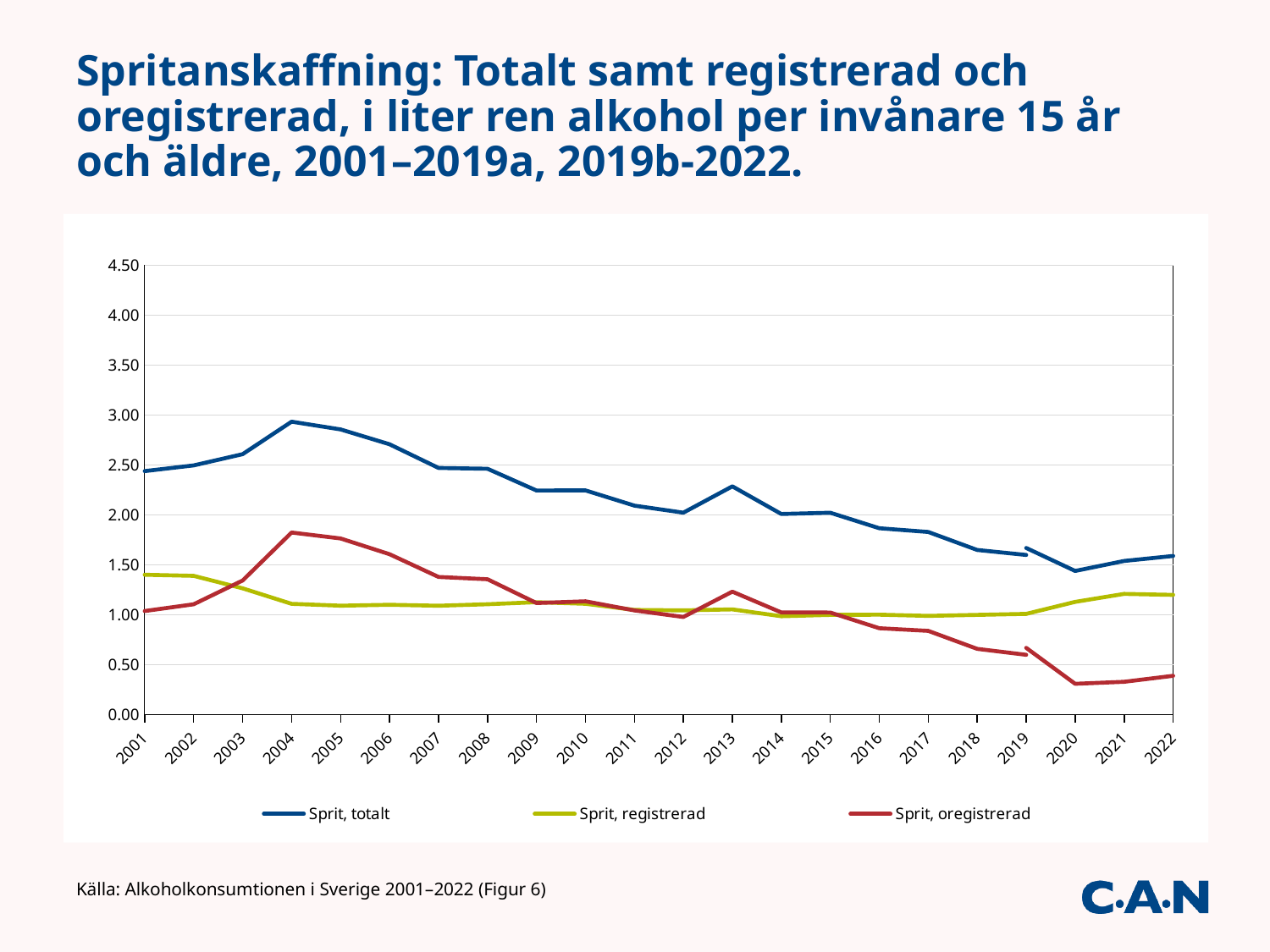
What kind of chart is shown on the slide? Line chart In which year does the Sprit, totalt series reach its highest value? 2004 Is the value for Sprit, oregistrerad in 2020 greater or less than 0.50? less In which year does the Sprit, oregistrerad series reach its highest value? 2004 In which year is the Sprit, totalt series at its lowest? 2020 Does the Sprit, totalt series generally rise or fall from 2004 to 2022? Fall In 2004, which is larger: Sprit, registrerad or Sprit, oregistrerad? Sprit, oregistrerad How many series does the legend list? 3 Is the value for Sprit, oregistrerad in 2004 greater or less than 1.50? greater Is the value for Sprit, totalt in 2004 greater or less than 2.50? greater In 2022, which is larger: Sprit, registrerad or Sprit, oregistrerad? Sprit, registrerad How many years are shown along the x axis? 22